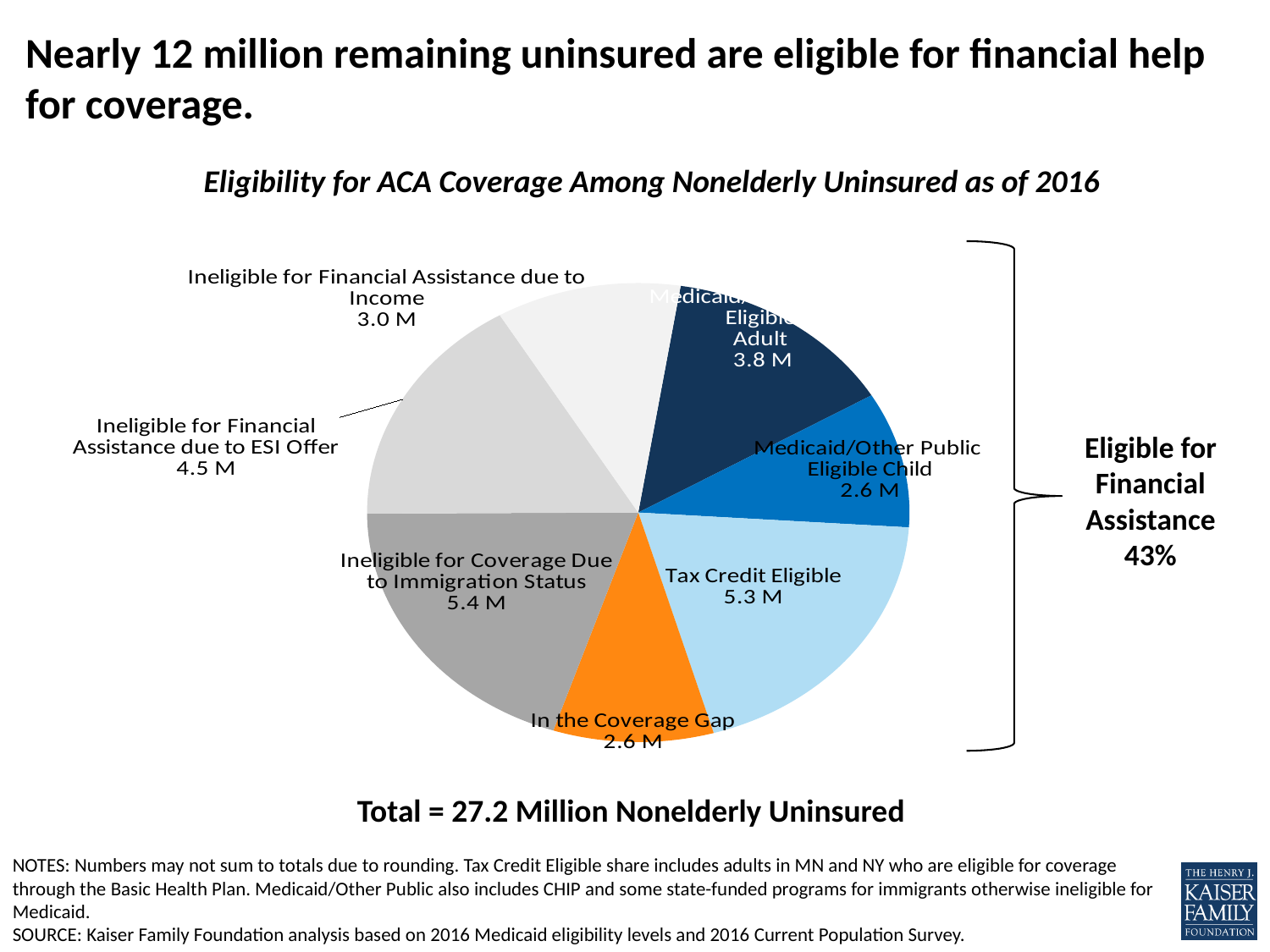
What is the title of the chart? Eligibility for ACA Coverage Among Nonelderly Uninsured as of 2016 How many slices does the pie chart have? 7 What is the value for Medicaid/Other Public Eligible Adult? 3.8 M What is the difference between Ineligible for Coverage Due to Immigration Status and Ineligible for Financial Assistance due to Income? 2.4 M Which category has the largest value? Ineligible for Coverage Due to Immigration Status What is the total number of nonelderly uninsured shown below the chart? 27.2 Million What type of chart is shown on the slide? Pie chart What is the value for In the Coverage Gap? 2.6 M What is the value for Ineligible for Financial Assistance due to ESI Offer? 4.5 M What is the value for Tax Credit Eligible? 5.3 M Which is larger: Ineligible for Financial Assistance due to ESI Offer or Ineligible for Financial Assistance due to Income? Ineligible for Financial Assistance due to ESI Offer What share of the nonelderly uninsured is eligible for financial assistance, according to the chart? 43%